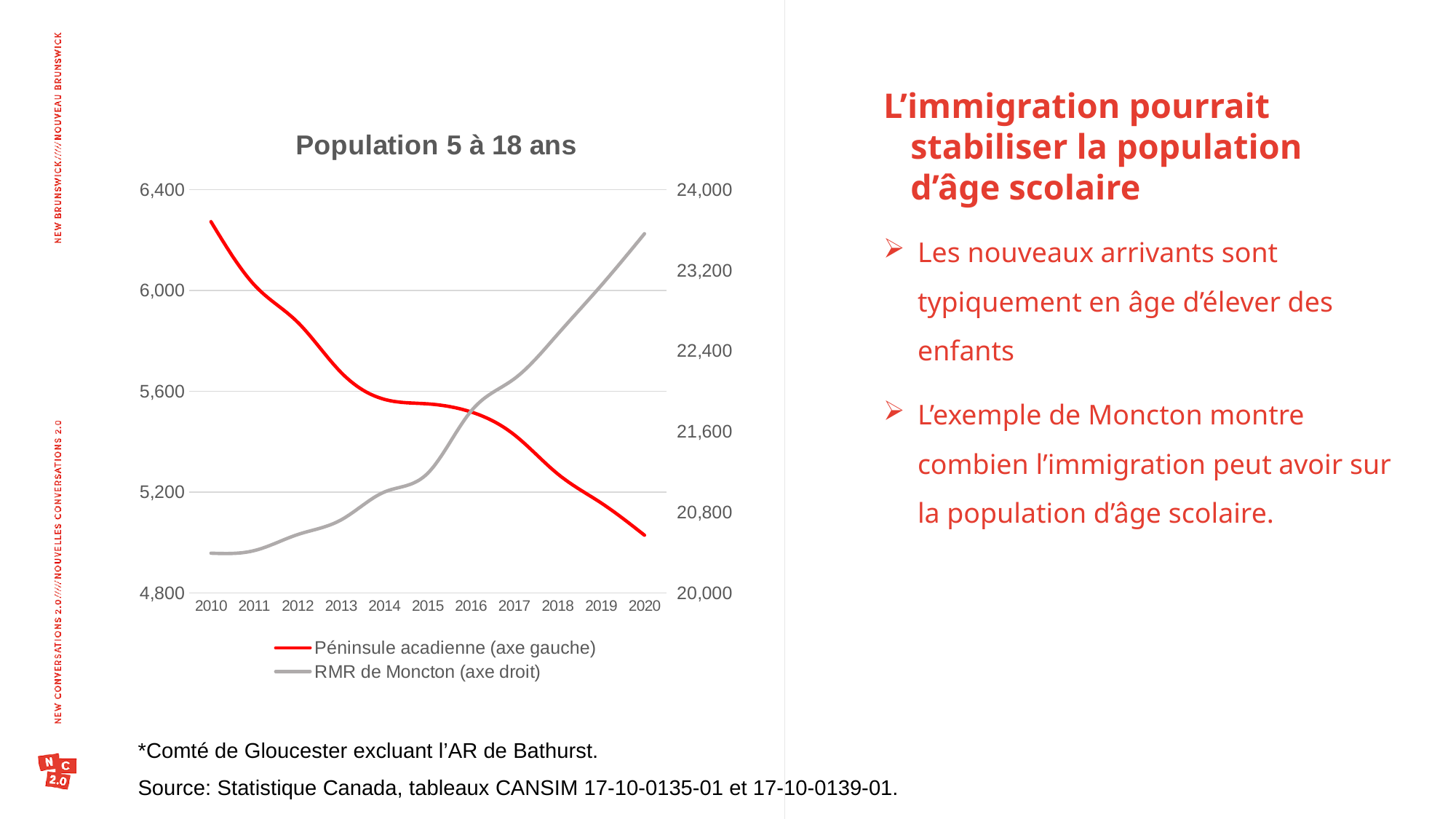
Does the RMR de Moncton series rise or fall from 2010 to 2020? rise Is the value for Péninsule acadienne in 2020 greater or less than 5,200? less What type of chart is shown on the slide? line chart How many series does the chart's legend list? 2 In which year is the Péninsule acadienne series at its highest? 2010 How many years are shown on the x axis of the chart? 11 Is the value for Péninsule acadienne in 2010 greater or less than 6,000? greater Does the Péninsule acadienne series rise or fall from 2010 to 2020? fall In which year is the RMR de Moncton series at its highest? 2020 What is the title of the chart? Population 5 à 18 ans In which year is the Péninsule acadienne series at its lowest? 2020 Is the value for RMR de Moncton in 2020 greater or less than 23,200? greater